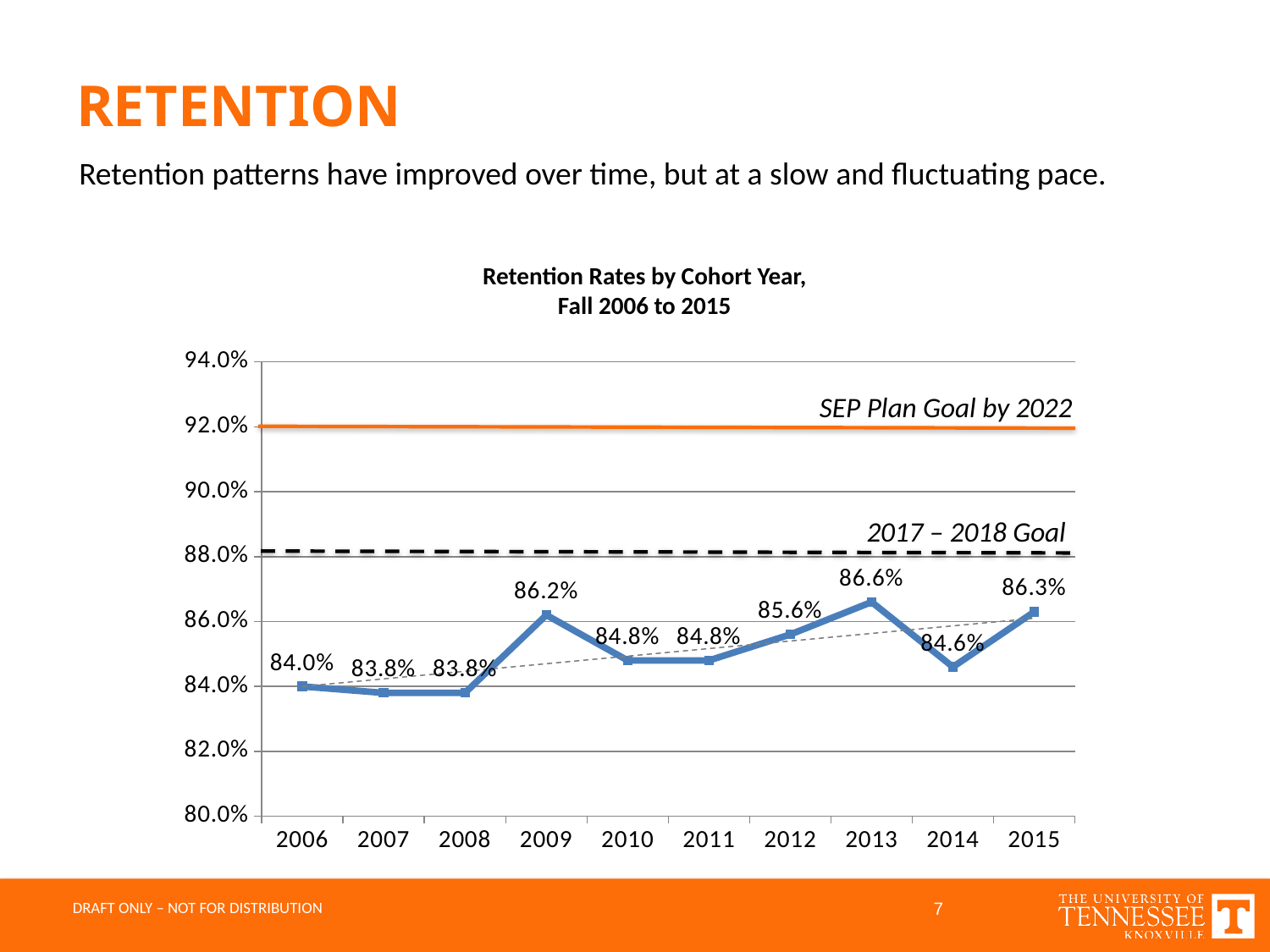
What is the retention rate for the 2015 cohort? 86.3% What kind of chart is shown on the slide? line chart Which cohort has the higher retention rate, 2012 or 2015? 2015 What is the title of the chart? Retention Rates by Cohort Year, Fall 2006 to 2015 Is the SEP Plan Goal by 2022 line greater or less than 90.0%? greater What is the retention rate for the 2009 cohort? 86.2% How many cohort years are plotted on the chart? 10 What is the retention rate for the 2014 cohort? 84.6% From 2011 to 2013, do the retention rates rise or fall? rise Which cohort year has the highest retention rate? 2013 What label is shown next to the orange horizontal line on the chart? SEP Plan Goal by 2022 What is the difference between the retention rates for the 2013 and 2006 cohorts? 2.6 percentage points